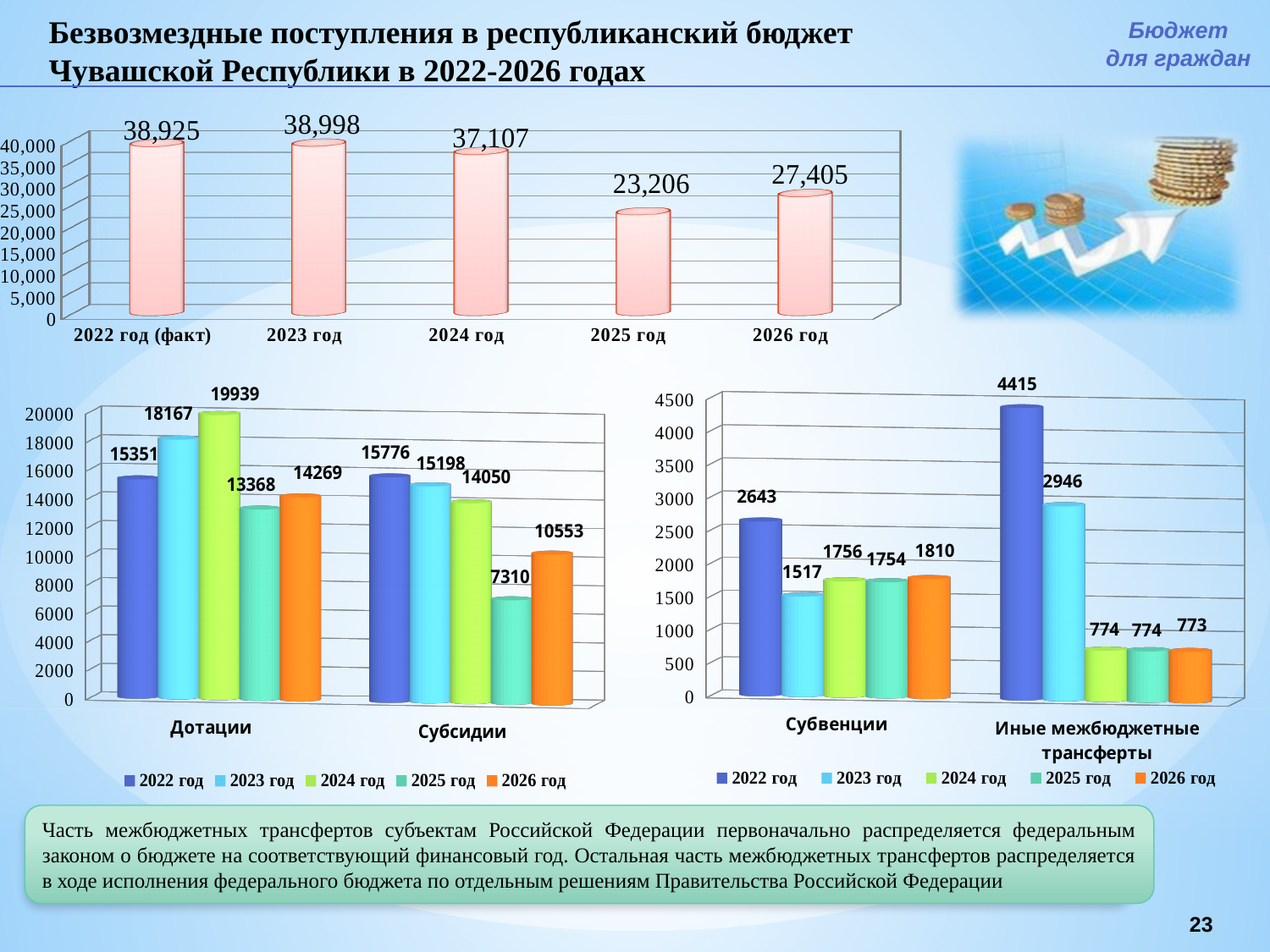
In the top chart, what is the difference between the values for 2024 год and 2025 год? 13,901 In the top chart, what is the value for 2023 год? 38,998 In the top chart, which year has the highest value? 2023 год In the bottom-right chart, what is the value for Иные межбюджетные трансферты in 2022 год? 4415 In the bottom-left chart, what is the value for Дотации in 2024 год? 19939 In the bottom-left chart, which is larger: Дотации in 2022 год or Субсидии in 2022 год? Субсидии in 2022 год In the top chart, how many years are plotted? 5 In the bottom-left chart, what is the value for Субсидии in 2025 год? 7310 In the bottom-left chart, how many series does the legend list? 5 What type of chart is the bottom-right chart? bar chart In the top chart, which year has the lowest value? 2025 год In the bottom-right chart, what is the difference between Субвенции in 2022 год and Субвенции in 2023 год? 1126